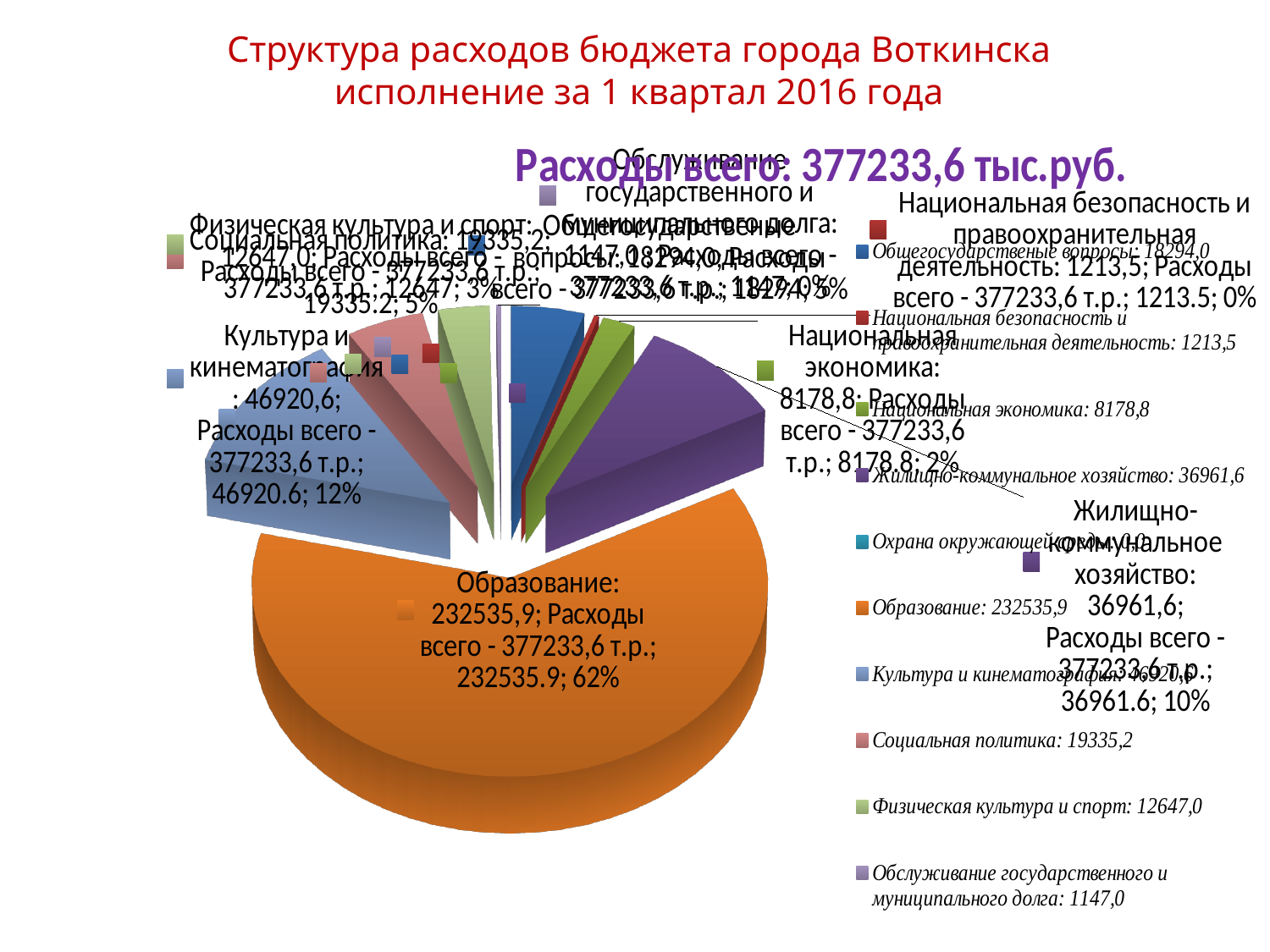
What is the value for Образование in the pie chart? 232535,9 Which category has the largest share of the pie? Образование What percentage share of the pie does Культура и кинематография have? 12% What type of chart is shown on the slide? pie chart Which is larger, Социальная политика or Физическая культура и спорт? Социальная политика What is the value for Обслуживание государственного и муниципального долга? 1147,0 Which category has the smallest value in the legend? Охрана окружающей среды What is the value for Жилищно-коммунальное хозяйство? 36961,6 What is the value for Национальная экономика? 8178,8 What percentage share of the pie does Образование have? 62% How many categories does the legend list? 10 What is the value for Культура и кинематография? 46920,6